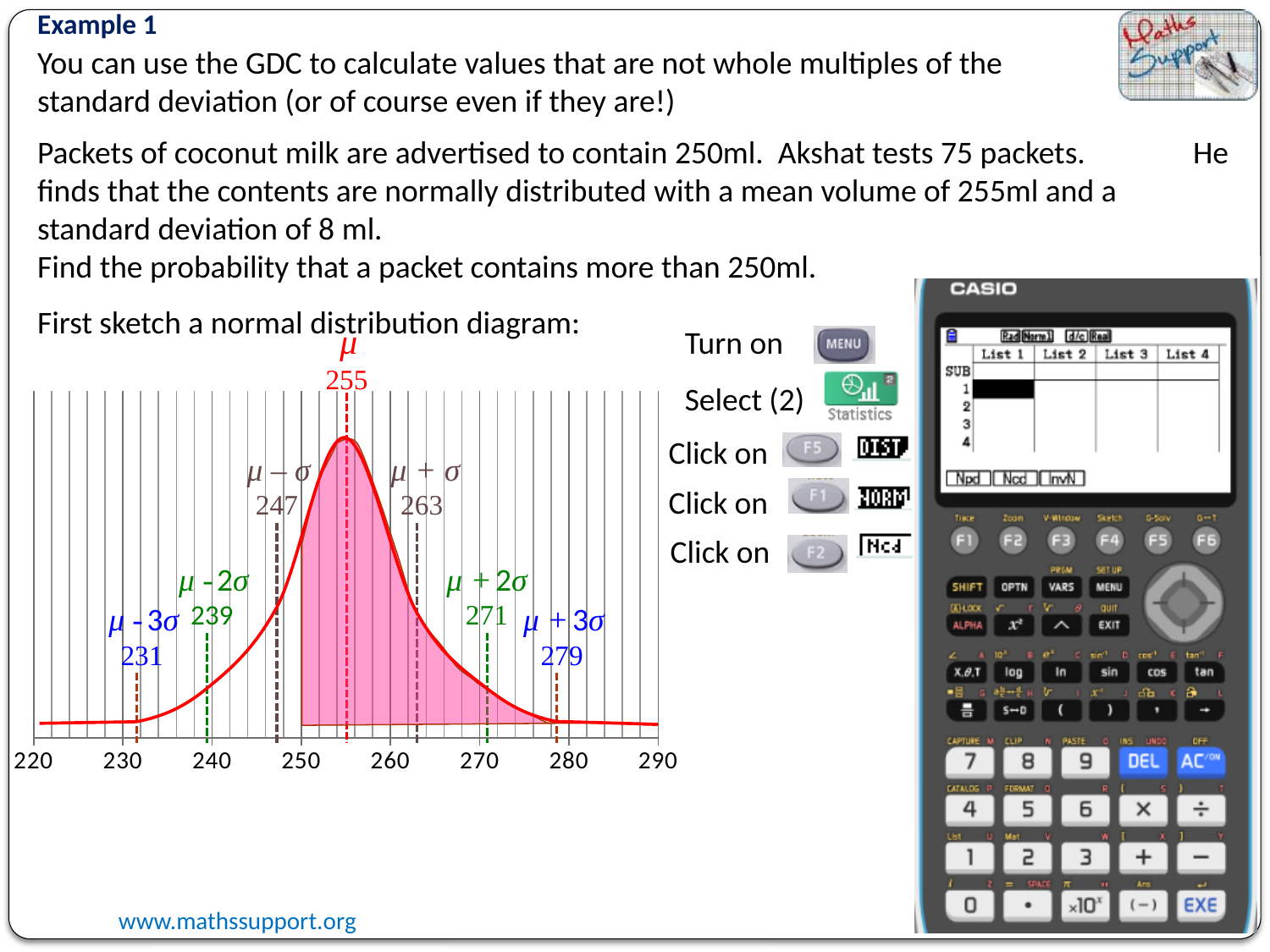
What is the difference between the values labelled at μ + 3σ and μ on the diagram? 24 What value is labelled at μ + 3σ on the normal distribution diagram? 279 What value is labelled at μ + 2σ on the normal distribution diagram? 271 What value is labelled at μ − 3σ on the normal distribution diagram? 231 What is the highest value printed on the x axis of the normal distribution diagram? 290 What is the difference between the values labelled at μ + σ and μ − σ on the diagram? 16 What value is labelled at μ − σ on the normal distribution diagram? 247 At what x-axis value does the shaded (pink) region of the normal distribution diagram begin? 250 What value is labelled at the mean (μ) on the normal distribution diagram? 255 Which is larger on the diagram, the value labelled at μ − 2σ or the value labelled at μ − σ? μ − σ What value is labelled at μ + σ on the normal distribution diagram? 263 What is the lowest value printed on the x axis of the normal distribution diagram? 220